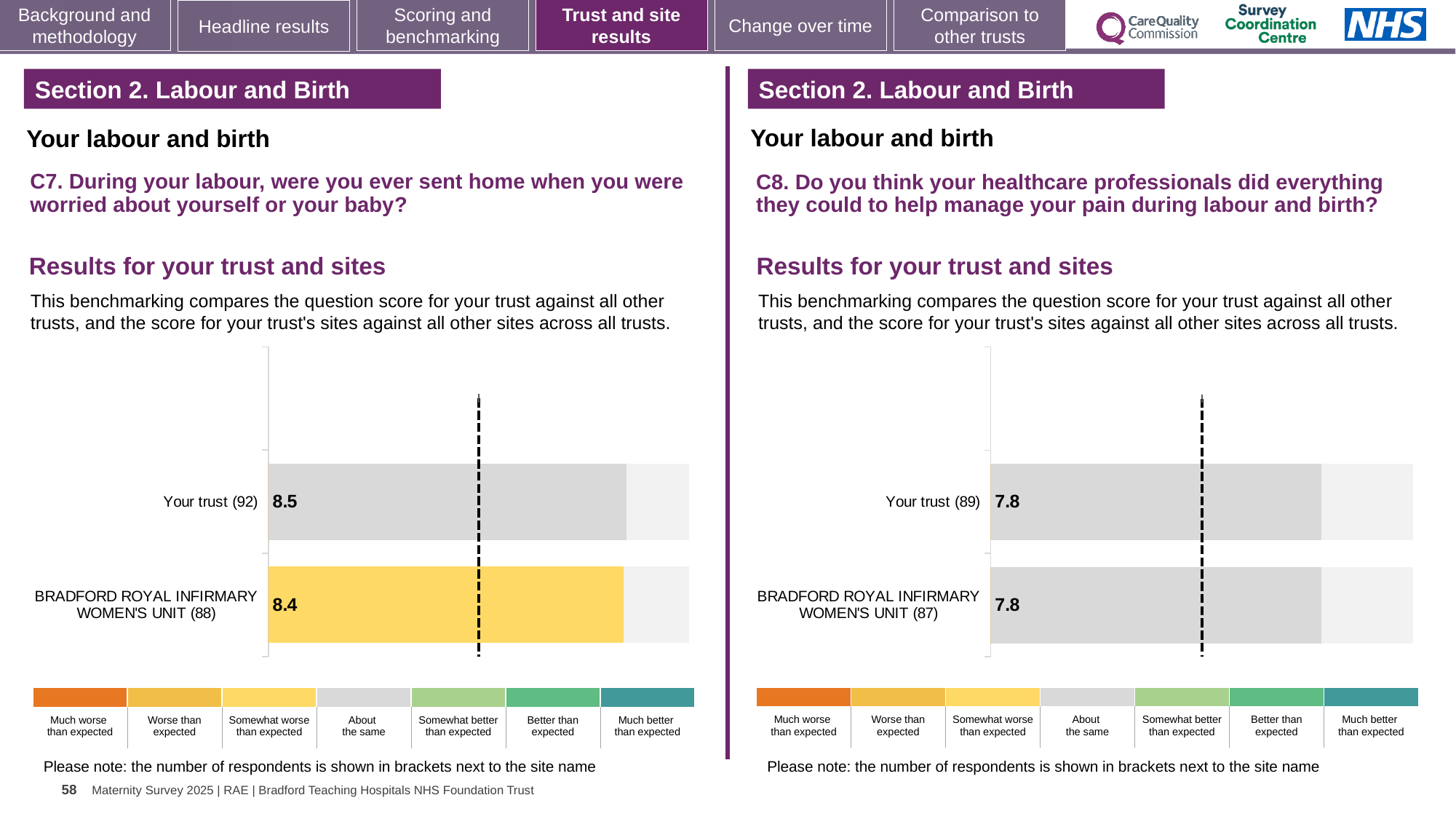
On the right chart (C8), how many respondents are shown in brackets for Bradford Royal Infirmary Women's Unit? 87 How many bars are plotted on the left chart (C7)? 2 On the left chart (C7), what is the difference between the score for Your trust and the score for Bradford Royal Infirmary Women's Unit? 0.1 What kind of chart is shown on the right (C8)? Bar chart On the left chart (C7), how many respondents are shown in brackets for Your trust? 92 On the left chart (C7), which has the higher score, Your trust or Bradford Royal Infirmary Women's Unit? Your trust On the right chart (C8), what is the score for Your trust? 7.8 On the left chart (C7), which benchmark category does the colour of the Bradford Royal Infirmary Women's Unit bar correspond to in the legend? Somewhat worse than expected On the right chart (C8), what is the difference between the score for Your trust and the score for Bradford Royal Infirmary Women's Unit? 0 On the right chart (C8), what is the score for Bradford Royal Infirmary Women's Unit? 7.8 On the left chart (C7), what is the score for Your trust? 8.5 On the left chart (C7), what is the score for Bradford Royal Infirmary Women's Unit? 8.4